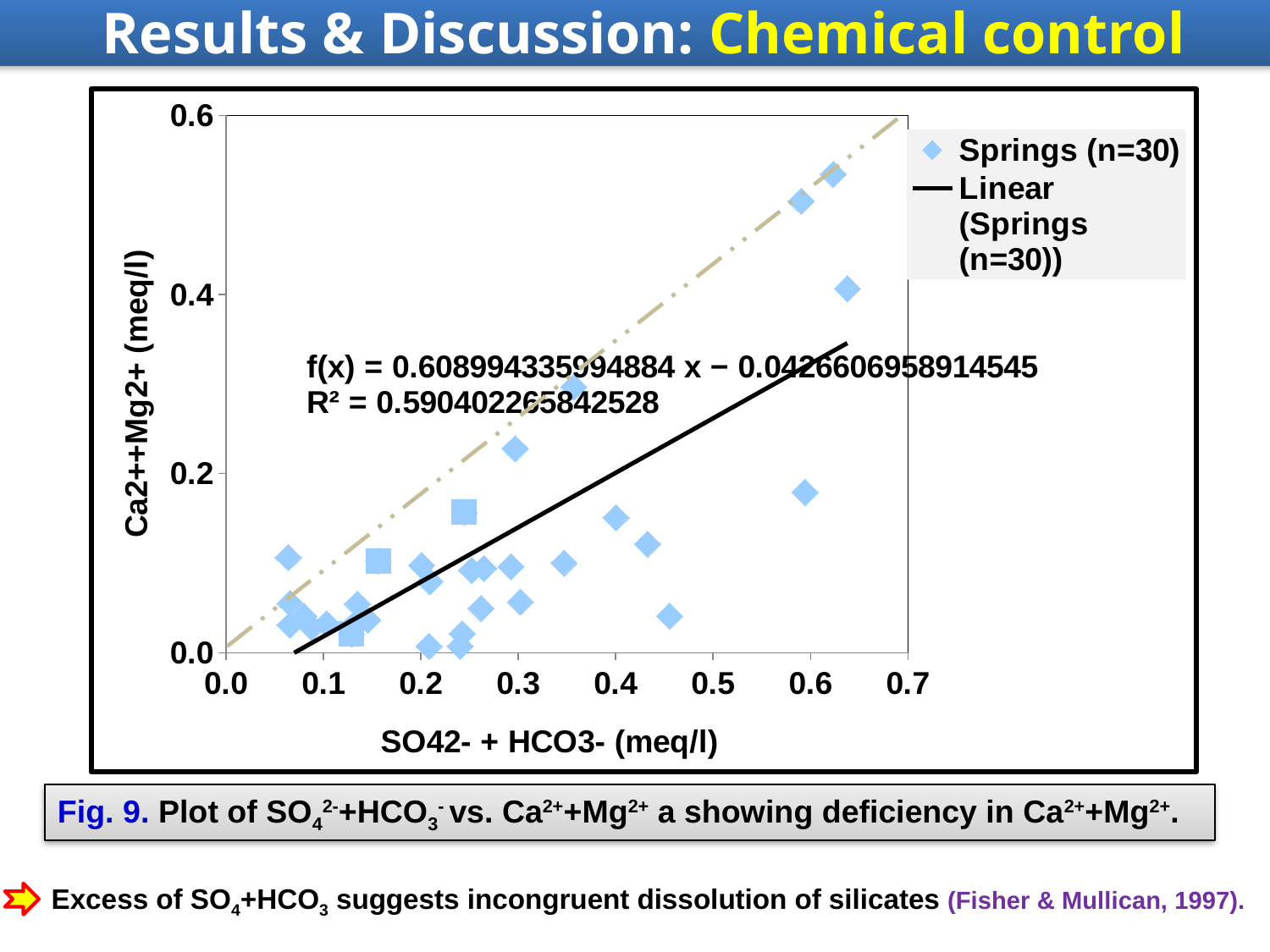
What is the slope of the fitted line f(x) printed on the chart? 0.608994335994884 What is the maximum value shown on the x axis? 0.7 Is the highest plotted Ca2++Mg2+ value greater or less than 0.4 meq/l? greater Do the Ca2++Mg2+ values generally rise or fall as SO42- + HCO3- increases along the x axis? rise What is the label of the y axis? Ca2++Mg2+ (meq/l) What is the maximum value shown on the y axis? 0.6 What is the label of the x axis? SO42- + HCO3- (meq/l) How many spring samples (n) are plotted according to the legend? 30 What is the intercept of the fitted line f(x) printed on the chart? −0.0426606958914545 What kind of chart is shown on the slide? scatter chart What is the R² value printed on the chart? 0.590402265842528 How many entries does the legend list? 2